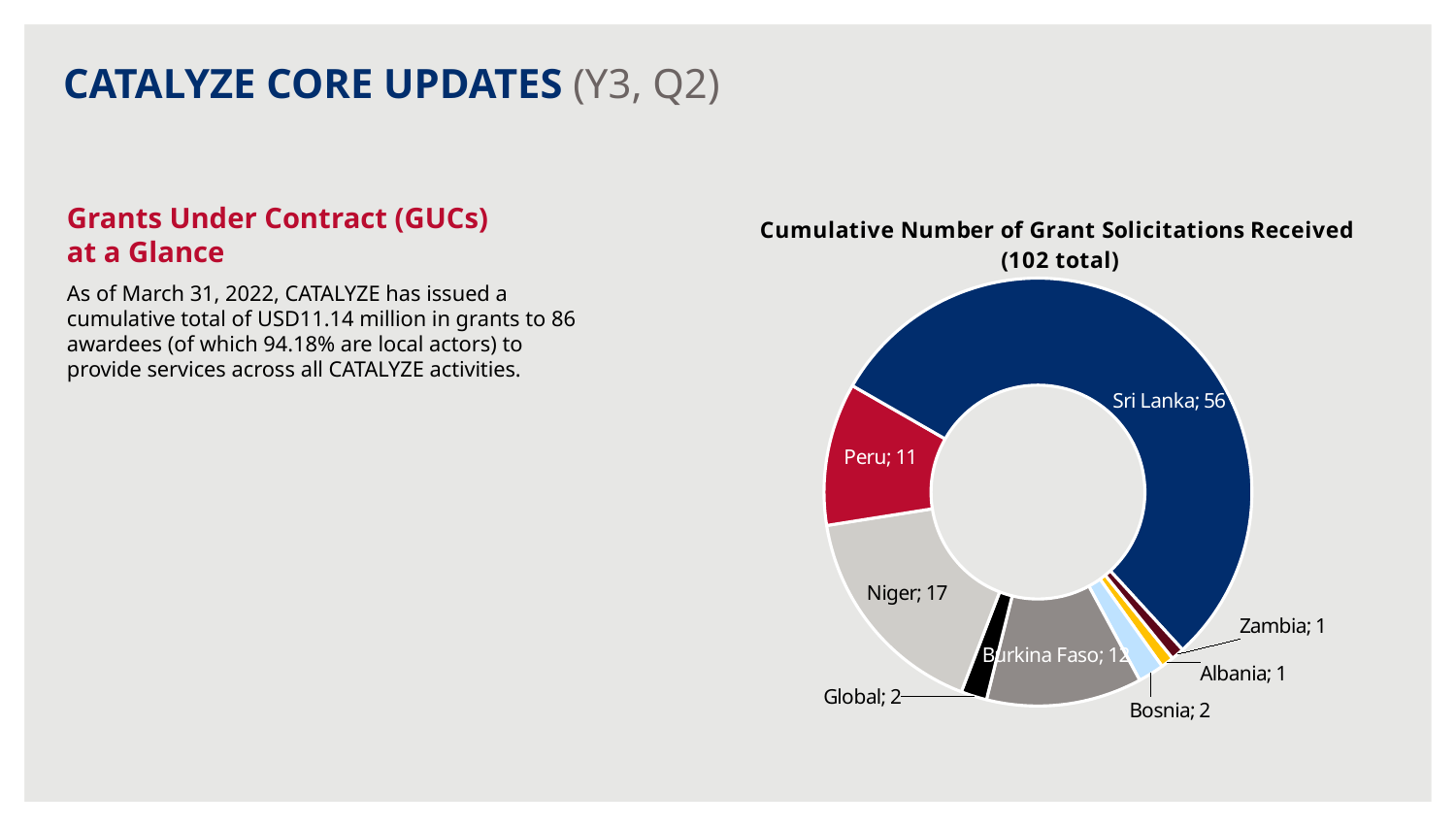
How many categories are shown in the chart? 8 What is the difference between the number of grant solicitations from Sri Lanka and from Niger? 39 What is the total number of grant solicitations received according to the chart title? 102 How many grant solicitations were received from Sri Lanka? 56 How many grant solicitations were received from Bosnia? 2 What kind of chart is shown on the slide? Doughnut (pie) chart Which country accounts for the largest number of grant solicitations received? Sri Lanka Which received more grant solicitations, Niger or Burkina Faso? Niger What is the title of the chart? Cumulative Number of Grant Solicitations Received (102 total) Which categories have the smallest number of grant solicitations received? Zambia and Albania How many grant solicitations were received from Niger? 17 How many grant solicitations were received from Peru? 11